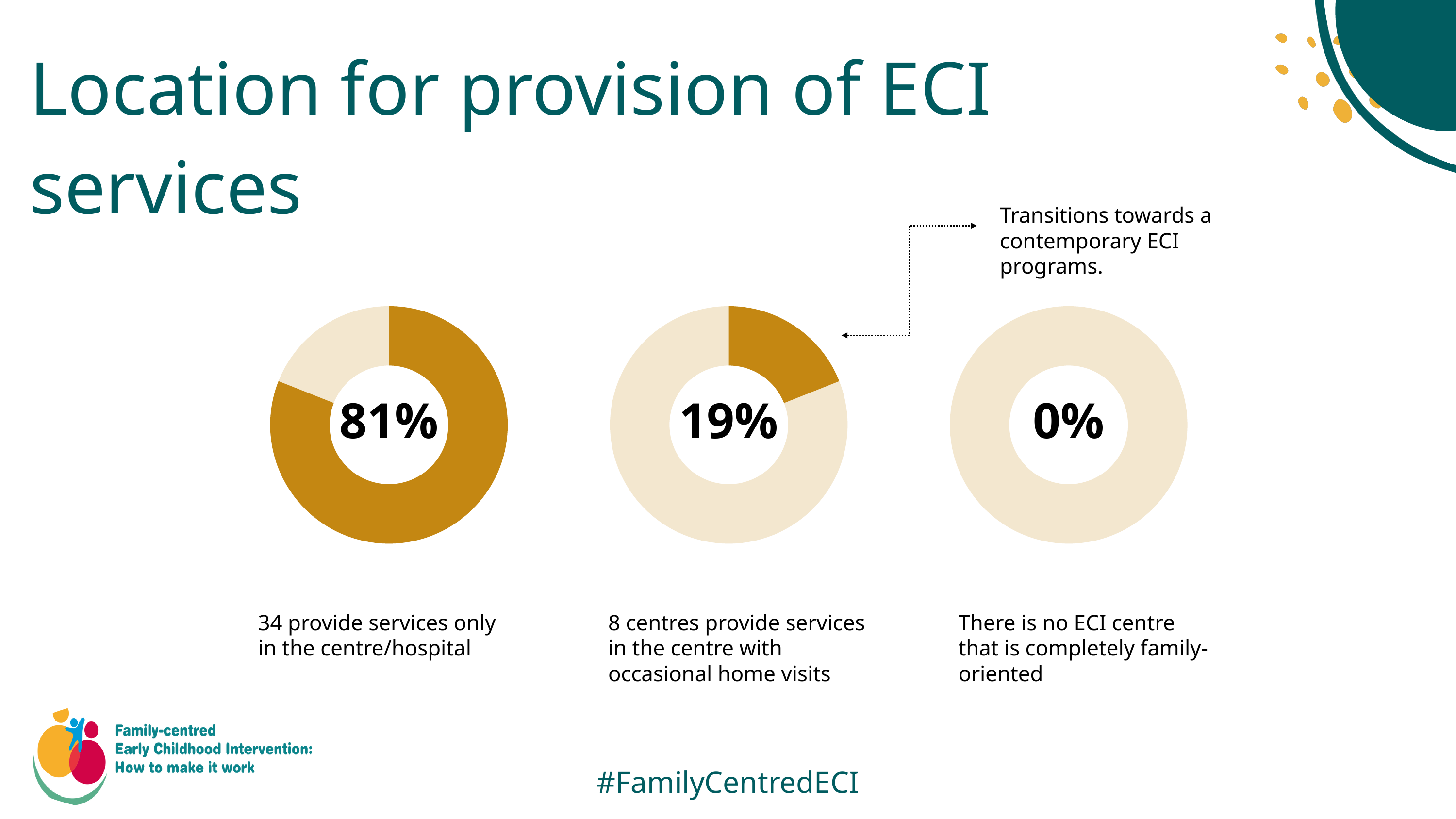
Which is larger, the percentage in the middle donut chart or the percentage in the right donut chart? The middle chart (19%) How many donut charts are shown on the slide? 3 What percentage is shown in the centre of the left donut chart? 81% According to the caption under the left donut chart, how many centres provide services only in the centre/hospital? 34 Which donut chart shows the highest percentage? The left chart (81%) What is the difference between the percentage in the left donut chart and the percentage in the middle donut chart? 62% What is the title of the slide? Location for provision of ECI services What percentage is shown in the centre of the right donut chart? 0% What percentage is shown in the centre of the middle donut chart? 19% According to the caption under the middle donut chart, how many centres provide services in the centre with occasional home visits? 8 What kind of charts are shown on the slide? Donut (pie) charts Which donut chart shows the lowest percentage? The right chart (0%)